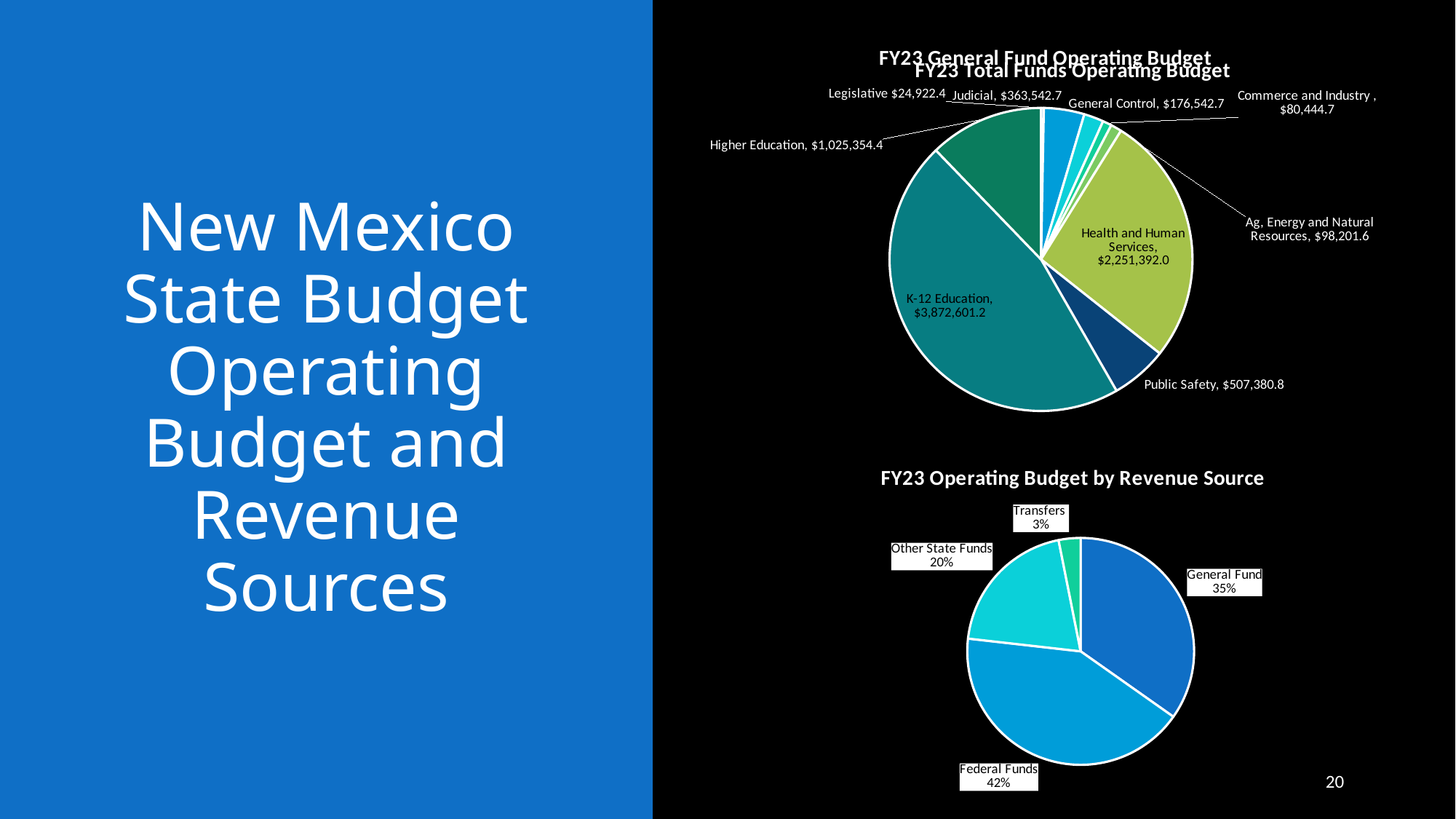
In the top pie chart, which is larger, Judicial or General Control? Judicial In the FY23 Operating Budget by Revenue Source chart, which revenue source has the largest share? Federal Funds What kind of chart is the FY23 Operating Budget by Revenue Source chart? Pie chart In the FY23 Operating Budget by Revenue Source chart, what share is Federal Funds? 42% In the FY23 Operating Budget by Revenue Source chart, how much larger is the Federal Funds share than the General Fund share? 7 percentage points In the FY23 Operating Budget by Revenue Source chart, which revenue source has the smallest share? Transfers In the top pie chart, which category has the largest value? K-12 Education In the top pie chart, which category has the smallest value? Legislative In the top pie chart, what is the value for K-12 Education? $3,872,601.2 In the top pie chart, what is the value for Health and Human Services? $2,251,392.0 How many slices does the FY23 Operating Budget by Revenue Source chart have? 4 In the top pie chart, what is the difference between Higher Education and Public Safety? $517,973.6